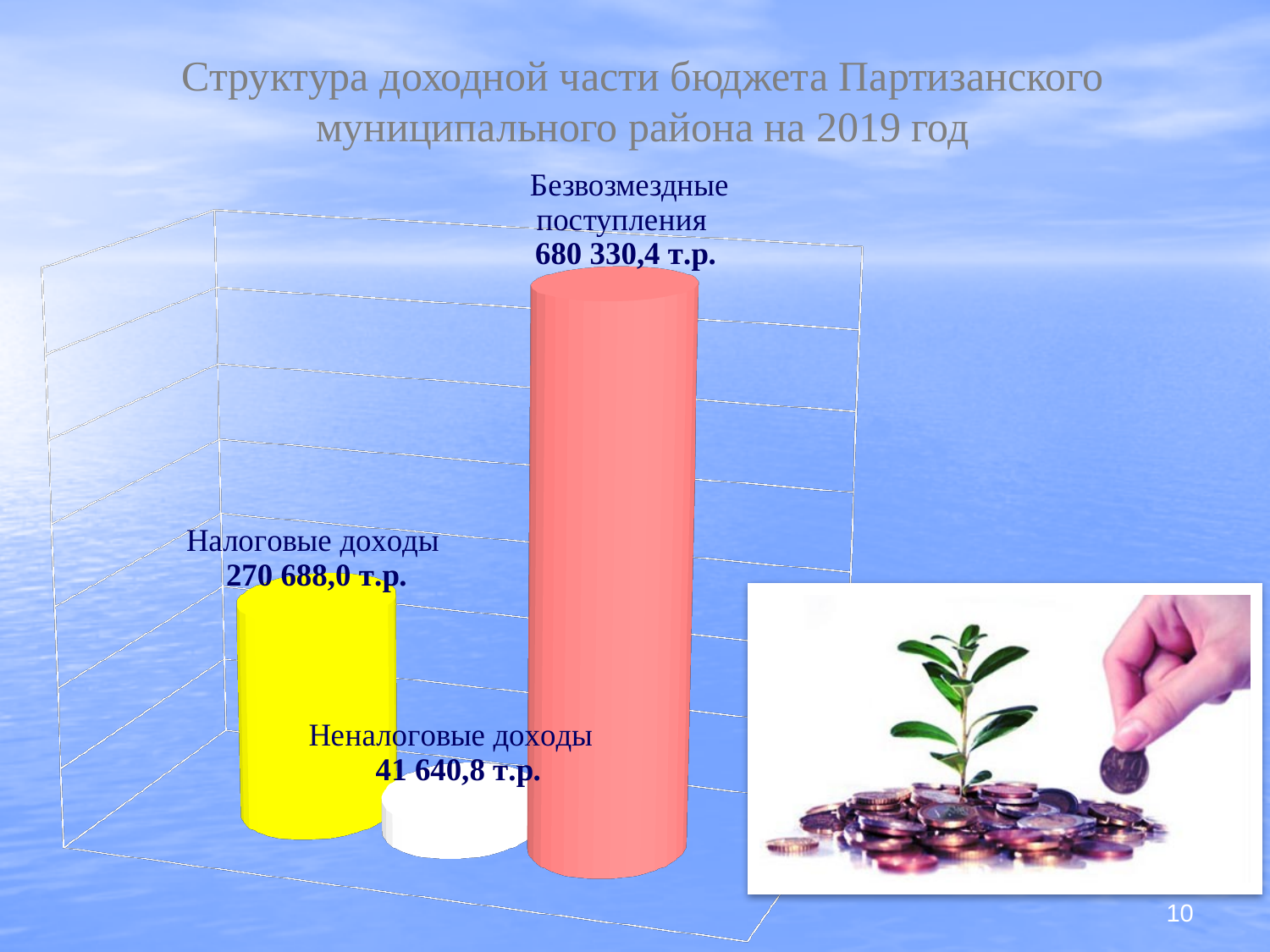
What is the difference between Безвозмездные поступления and Налоговые доходы? 409 642,4 т.р. What colour is the bar for Налоговые доходы? Yellow What is the total of the three values shown in the chart? 992 659,2 т.р. Which category has the lowest value? Неналоговые доходы What is the difference between Налоговые доходы and Неналоговые доходы? 229 047,2 т.р. What is the value shown for Неналоговые доходы? 41 640,8 т.р. Which is larger, Налоговые доходы or Неналоговые доходы? Налоговые доходы Which category has the highest value? Безвозмездные поступления What kind of chart is shown on the slide? Bar chart How many categories are shown in the chart? 3 What is the value shown for Безвозмездные поступления? 680 330,4 т.р. What is the value shown for Налоговые доходы? 270 688,0 т.р.